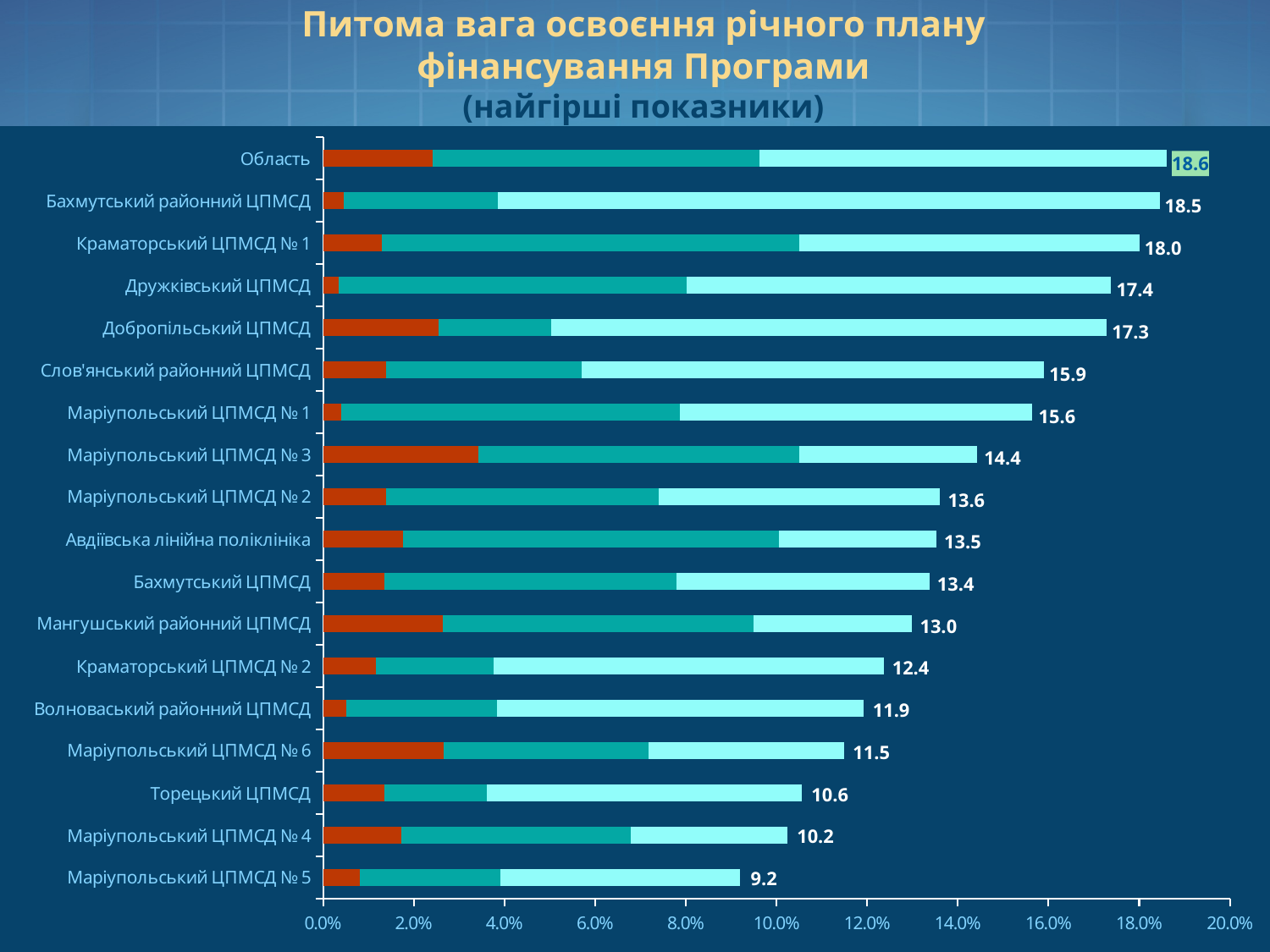
What is the value shown for Дружківський ЦПМСД? 17.4 What is the maximum value shown on the horizontal axis? 20.0% What is the value shown for Торецький ЦПМСД? 10.6 Which has a larger value, Краматорський ЦПМСД № 1 or Краматорський ЦПМСД № 2? Краматорський ЦПМСД № 1 What is the value shown for Область? 18.6 How many categories are shown on the chart? 18 Which category has the lowest value? Маріупольський ЦПМСД № 5 What kind of chart is shown on the slide? Stacked bar chart Which category has the highest value? Область Is the value for Мангушський районний ЦПМСД greater or less than 12.0%? greater Do the values rise or fall going from the top category to the bottom category? Fall What is the difference between the values for Область and Маріупольський ЦПМСД № 5? 9.4